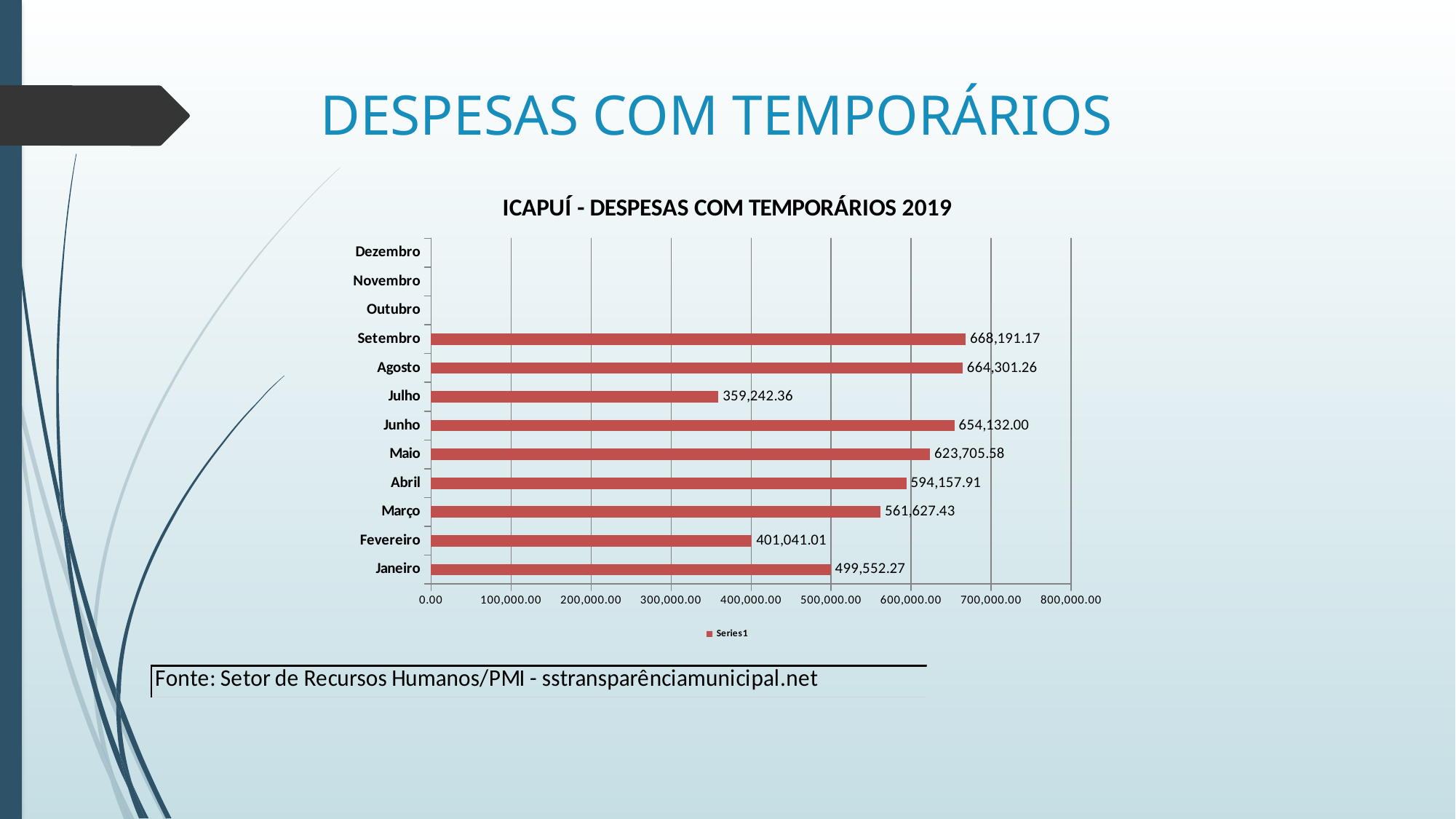
Which month with a plotted bar has the lowest value? Julho How many series does the legend list? 1 What is the value for Janeiro? 499,552.27 What kind of chart is shown? Bar chart What is the difference between the values for Junho and Julho? 294,889.64 What is the value for Setembro? 668,191.17 How many month categories are listed on the vertical axis? 12 What is the value for Julho? 359,242.36 What is the difference between the values for Janeiro and Fevereiro? 98,511.26 What is the value for Março? 561,627.43 Which month has the highest value? Setembro Which is larger, the value for Maio or the value for Abril? Maio